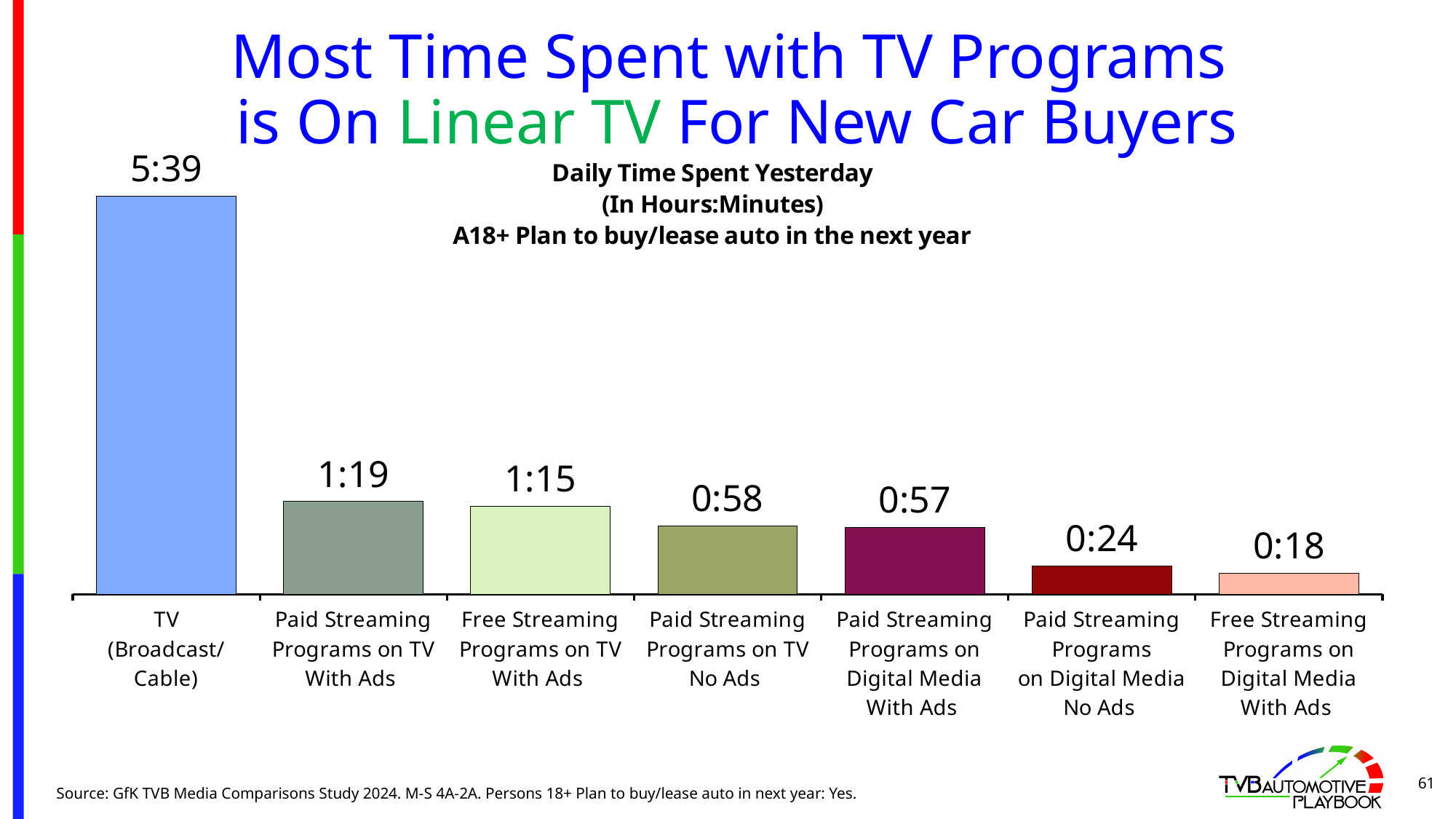
What is the daily time spent with Paid Streaming Programs on Digital Media No Ads? 0:24 What is the difference in daily time spent between Paid Streaming Programs on Digital Media No Ads and Free Streaming Programs on Digital Media With Ads? 0:06 What type of chart is shown on the slide? Bar chart What is the daily time spent with Paid Streaming Programs on TV With Ads? 1:19 How much more daily time is spent with TV (Broadcast/Cable) than with Paid Streaming Programs on TV With Ads? 4:20 What is the daily time spent with TV (Broadcast/Cable)? 5:39 What is the subtitle of the chart? Daily Time Spent Yesterday (In Hours:Minutes) A18+ Plan to buy/lease auto in the next year Which category has the highest daily time spent? TV (Broadcast/Cable) Which has more daily time spent: Free Streaming Programs on TV With Ads or Paid Streaming Programs on TV No Ads? Free Streaming Programs on TV With Ads How many categories are shown in the chart? 7 Which category has the lowest daily time spent? Free Streaming Programs on Digital Media With Ads What is the daily time spent with Free Streaming Programs on Digital Media With Ads? 0:18